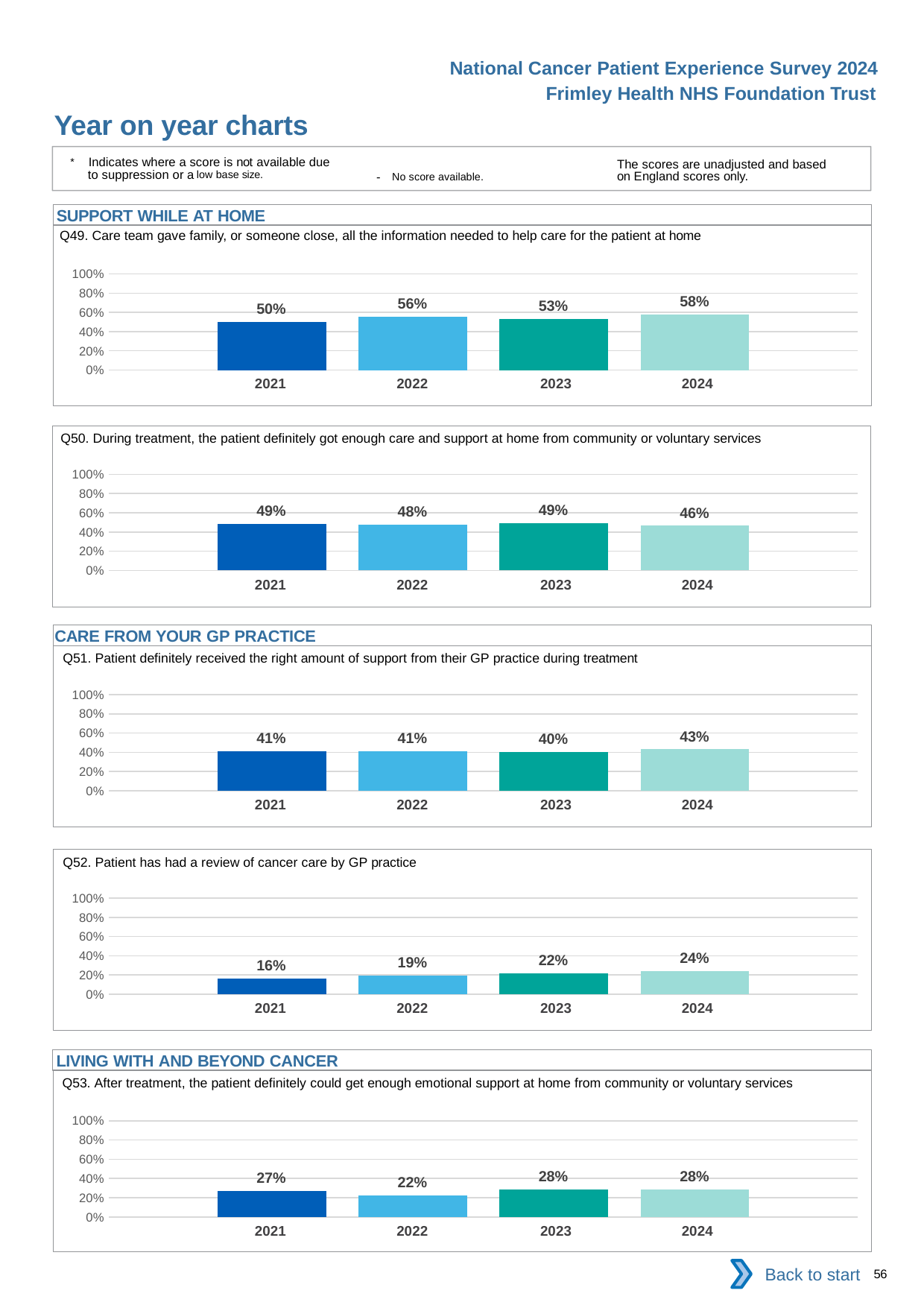
In the Q53 chart, is the value for 2023 larger or smaller than the value for 2022? larger In the Q49 chart, which year has the lowest value? 2021 In the Q50 chart, what is the difference between the 2021 value and the 2024 value? 3% How many years are shown on the x axis of the Q49 chart? 4 In the Q53 chart, which year has the lowest value? 2022 In the Q52 chart, what is the difference between the 2024 value and the 2021 value? 8% In the Q50 chart, what is the value for 2024? 46% In the Q52 chart, do the values rise or fall from 2021 to 2024? rise In the Q51 chart, what is the value for 2023? 40% What type of chart is used for Q52? bar chart In the Q49 chart, what is the value for 2024? 58% In the Q51 chart, which year has the highest value? 2024